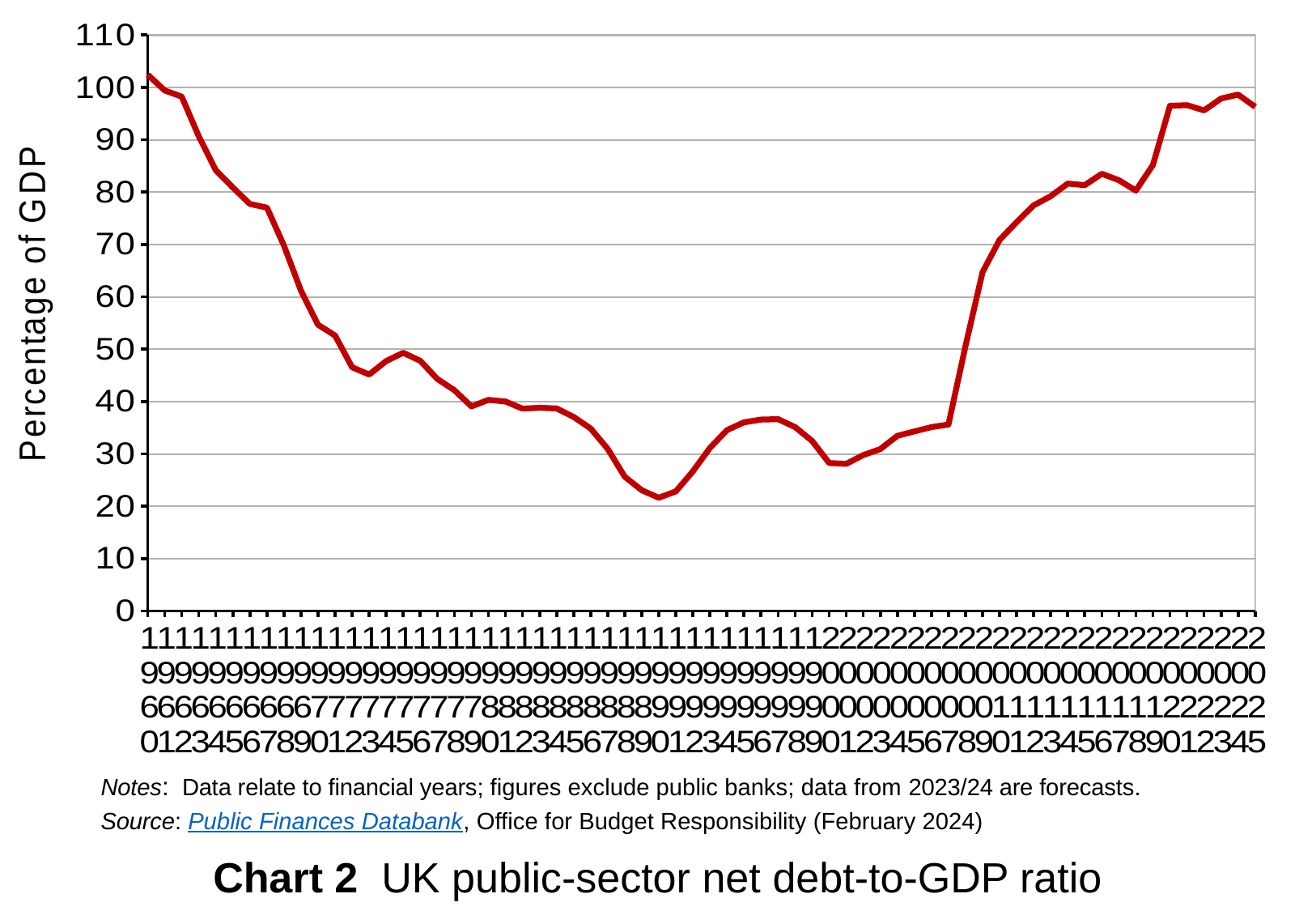
Does the value rise or fall between 2007 and 2020? rise Which is larger, the value for 1980 or the value for 2000? 1980 What is the label on the vertical axis? Percentage of GDP What kind of chart is Chart 2? line chart Which year has the highest value on the chart? 1960 Is the value for 1990 greater or less than 30? less Does the value rise or fall between 1960 and 1990? fall Is the value for 1960 greater or less than 100? greater Is the value for 2020 greater or less than 90? greater What is the title of the chart? Chart 2 UK public-sector net debt-to-GDP ratio